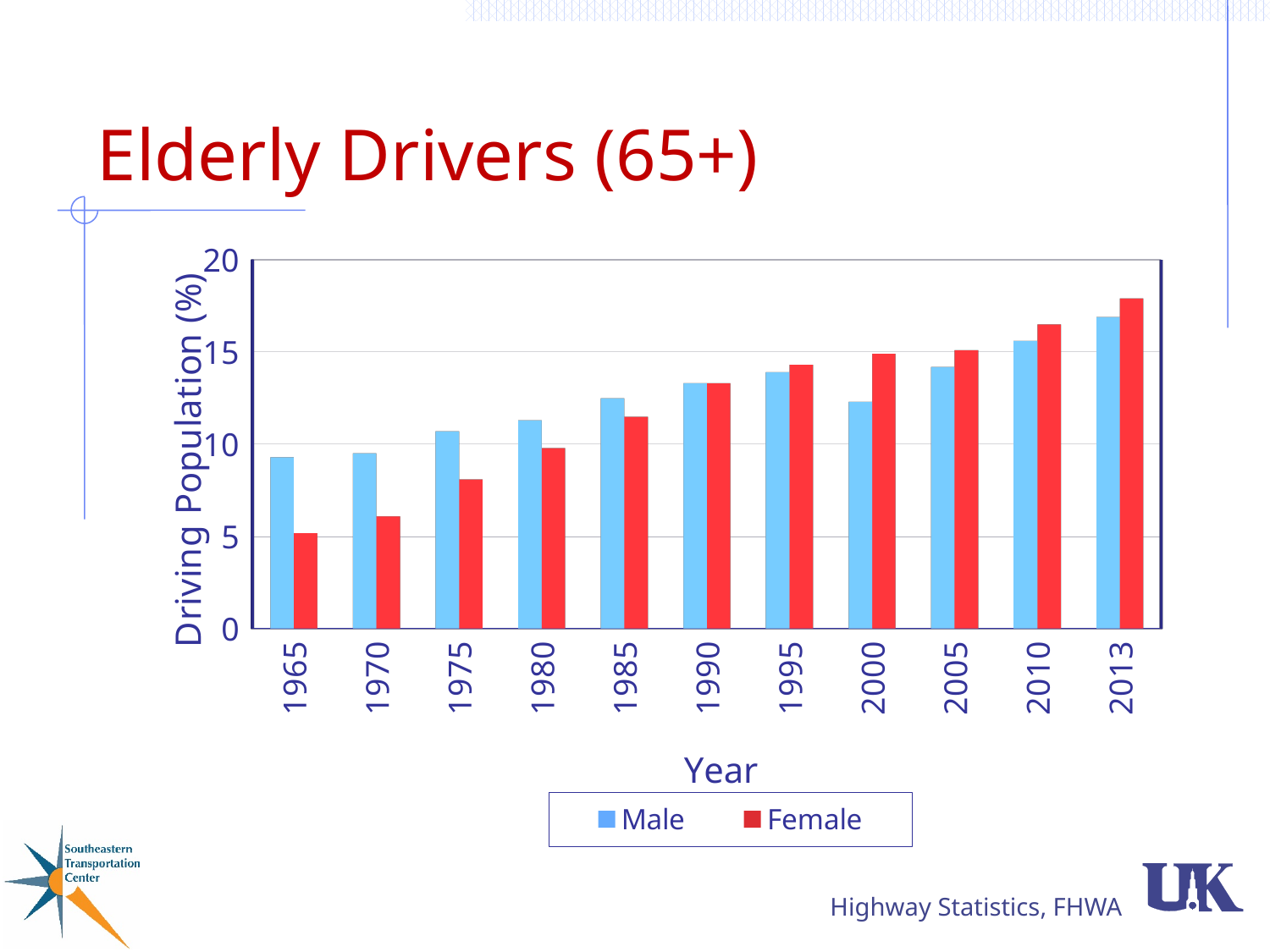
Is the Female value for 1965 greater or less than 10? less In which year is the Female value highest? 2013 What is the title of the y axis? Driving Population (%) How many years are shown on the x axis? 11 How many series does the legend list? 2 In 2013, which is larger, the Male or the Female value? Female In 1965, which is larger, the Male or the Female value? Male Do the Female values generally rise or fall from 1965 to 2013? rise Is the Male value for 2013 greater or less than 15? greater In which year is the Male value highest? 2013 What kind of chart is shown on the slide? Bar chart In which year is the Female value lowest? 1965